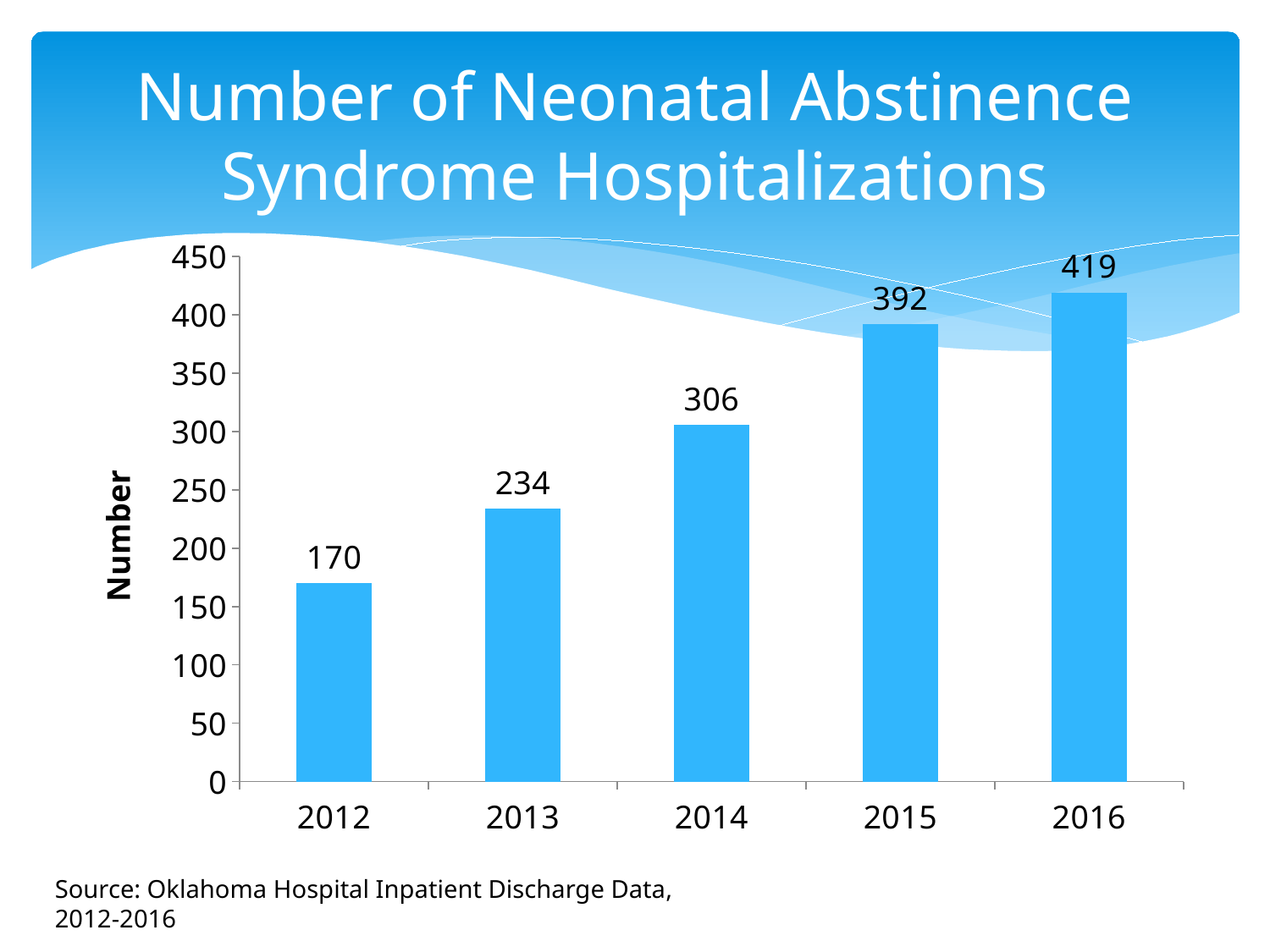
What was the number of neonatal abstinence syndrome hospitalizations in 2012? 170 What was the number of neonatal abstinence syndrome hospitalizations in 2014? 306 How many years are shown on the x axis? 5 What is the difference in hospitalizations between 2016 and 2012? 249 Is the value for 2013 greater or less than 250? less What was the number of neonatal abstinence syndrome hospitalizations in 2016? 419 What kind of chart is shown on the slide? Bar chart Which year had the lowest number of hospitalizations? 2012 Do the hospitalization numbers rise or fall from 2012 to 2016? Rise Which year had the highest number of hospitalizations? 2016 What is the difference in hospitalizations between 2015 and 2014? 86 Which year had more hospitalizations, 2013 or 2015? 2015